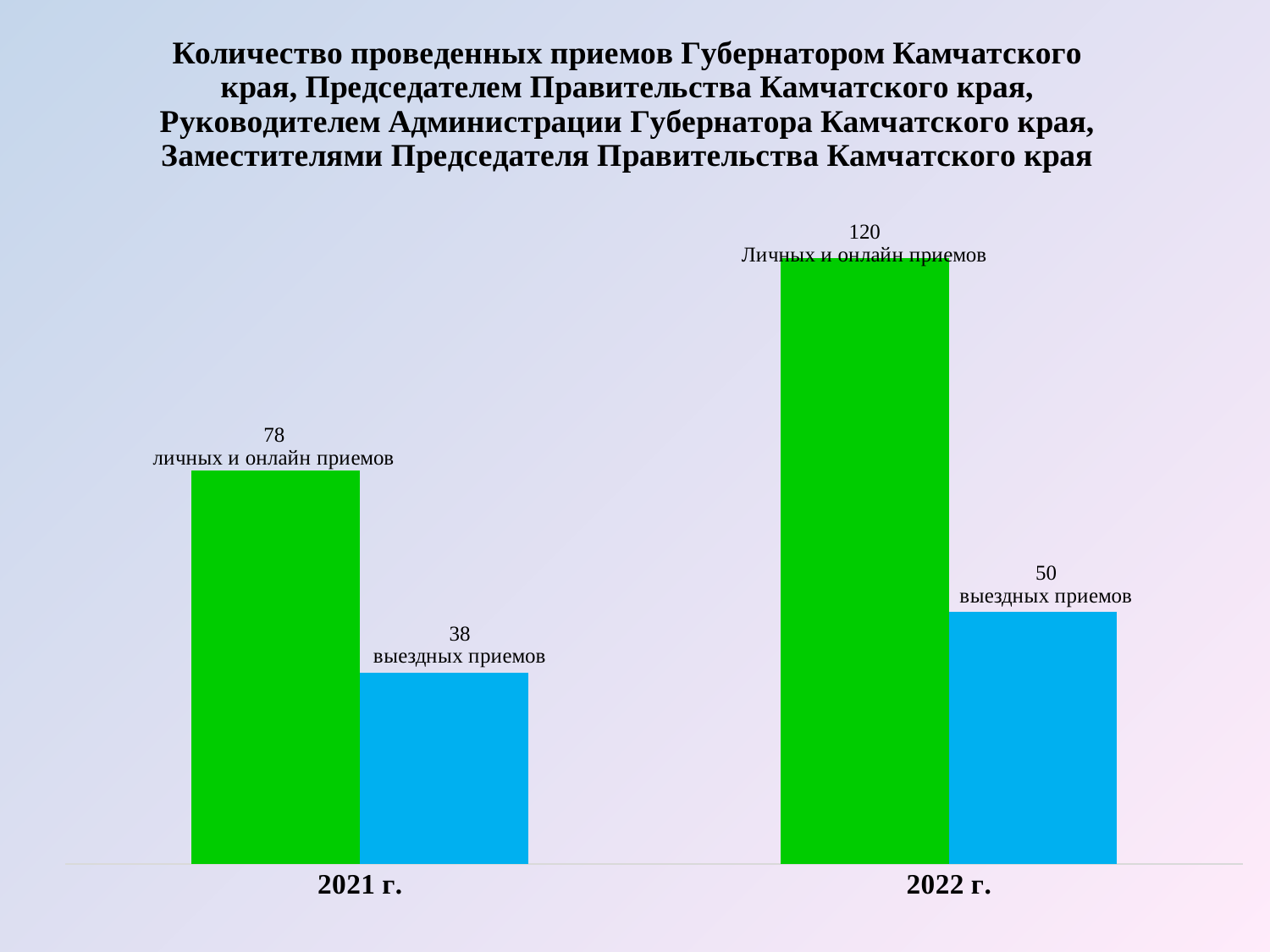
By how much did the number of personal and online receptions increase from 2021 г. to 2022 г.? 42 How many field receptions (выездных приемов) were held in 2022 г.? 50 What colour are the bars for personal and online receptions? green What kind of chart is shown on the slide? bar chart Which bar shows the lowest value on the chart? выездных приемов, 2021 г. What is the difference between field receptions in 2022 г. and 2021 г.? 12 How many field receptions (выездных приемов) were held in 2021 г.? 38 Which is larger: personal and online receptions in 2021 г. or field receptions in 2022 г.? personal and online receptions in 2021 г. How many personal and online receptions (личных и онлайн приемов) were held in 2022 г.? 120 How many personal and online receptions (личных и онлайн приемов) were held in 2021 г.? 78 How many year categories are shown on the x axis? 2 Which bar shows the highest value on the chart? Личных и онлайн приемов, 2022 г.